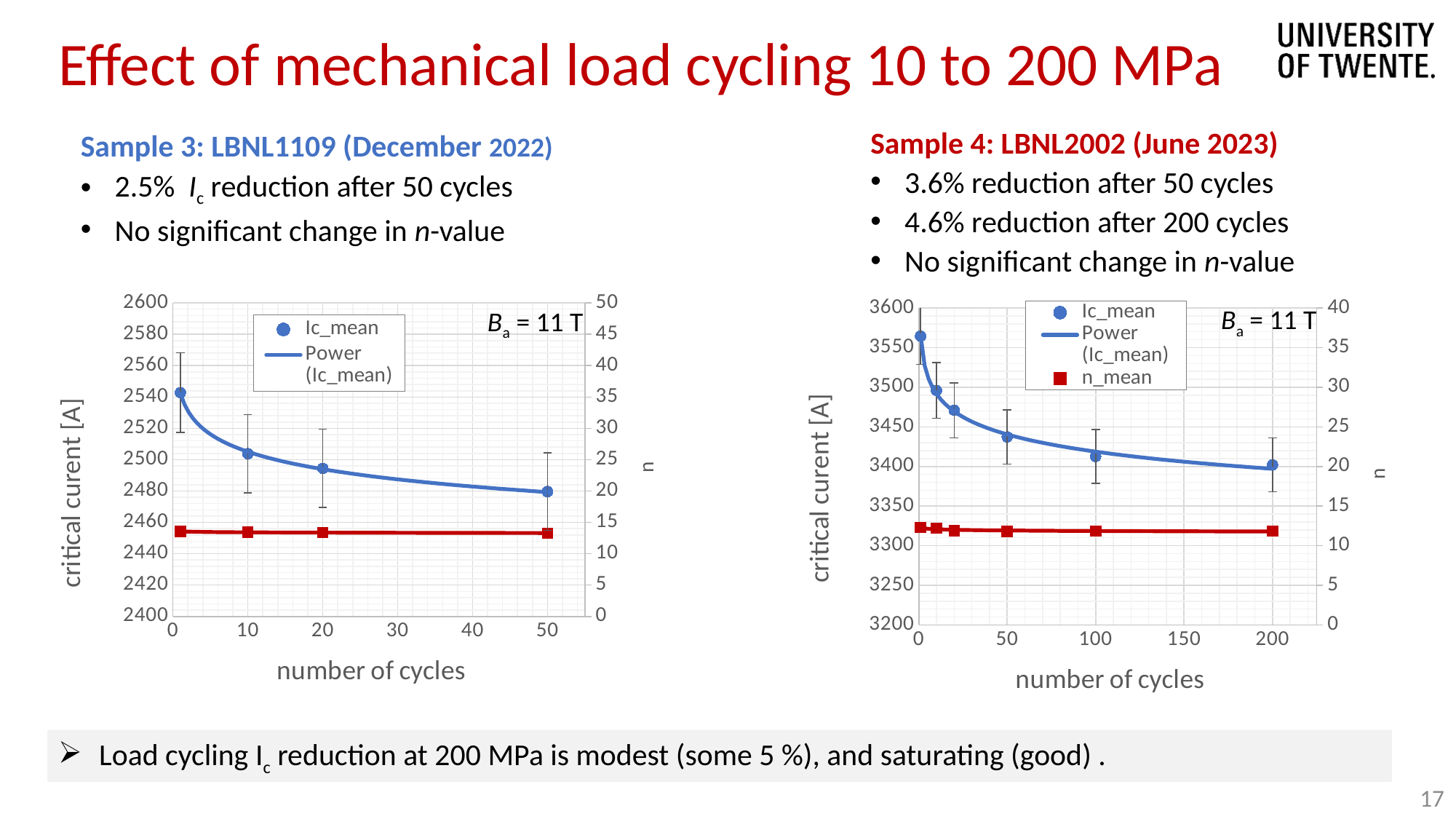
How many series does the legend of the left chart (Sample 3) list? 2 In the left chart (Sample 3), which is larger: the Ic_mean value at 1 cycle or at 50 cycles? 1 cycle How many series does the legend of the right chart (Sample 4) list? 3 In the left chart (Sample 3), is the Ic_mean value at 50 cycles greater or less than 2500? less In the left chart (Sample 3), does the critical current rise or fall as the number of cycles increases? fall In the right chart (Sample 4), is the first Ic_mean value (near 0 cycles) greater or less than 3500? greater In the right chart (Sample 4), does the critical current rise or fall as the number of cycles increases? fall In the right chart (Sample 4), is the n_mean value at 200 cycles greater or less than 15? less What is the x-axis label of the right chart (Sample 4)? number of cycles What kind of chart is the left chart (Sample 3)? scatter/line chart